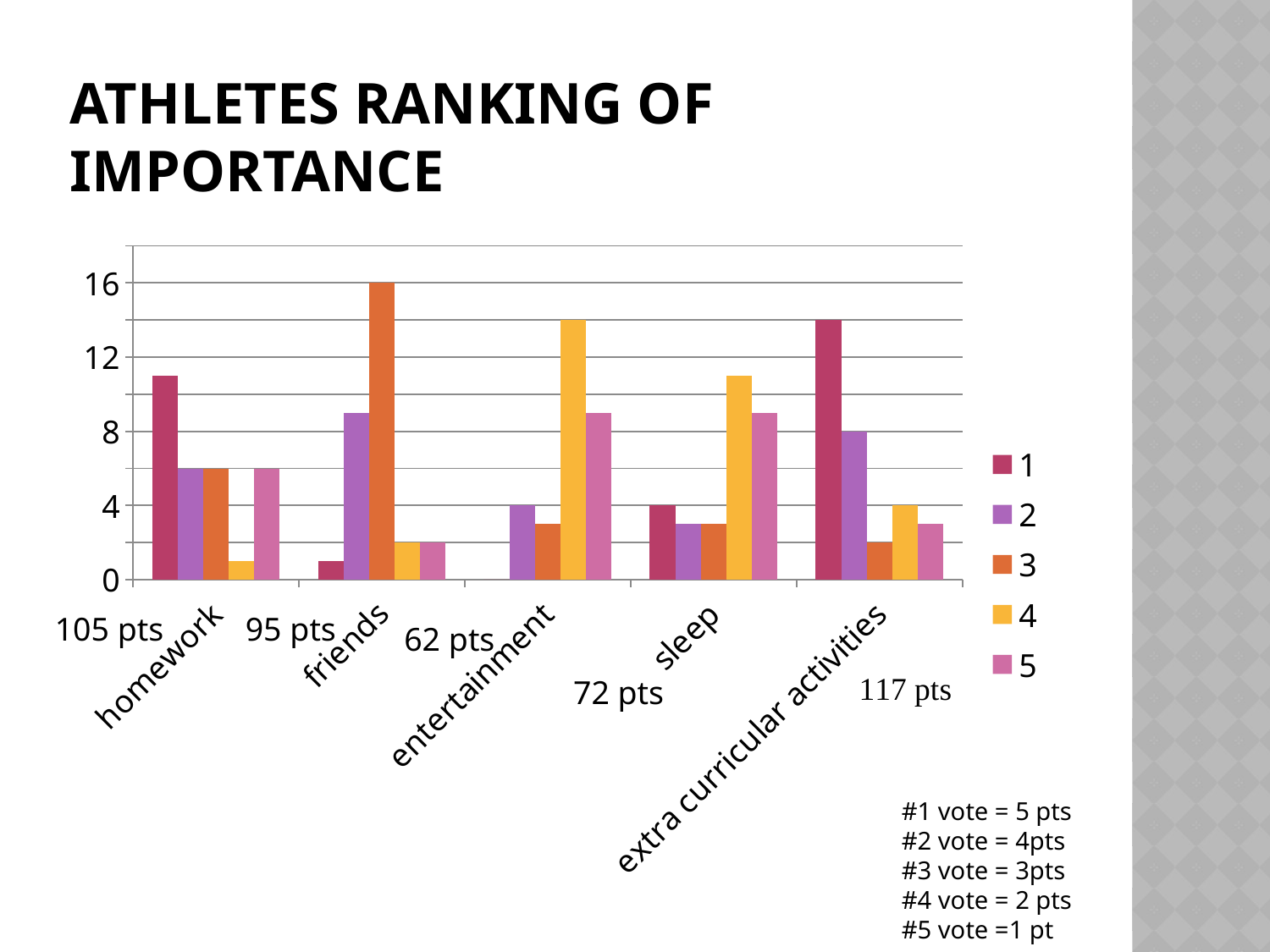
What kind of chart is shown on the slide? bar chart Is the value of series 1 for homework greater or less than 8? greater What is the value of series 2 for extra curricular activities? 8 Which is larger: series 1 for extra curricular activities or series 1 for homework? extra curricular activities Which category has the lowest value for series 1? entertainment What points total is shown next to extra curricular activities? 117 pts How many series does the chart's legend list? 5 What is the value of series 1 for sleep? 4 How many categories are shown on the x axis of the chart? 5 Which category has the highest value for series 4? entertainment What is the value of series 3 for friends? 16 Which category has the highest value for series 3? friends